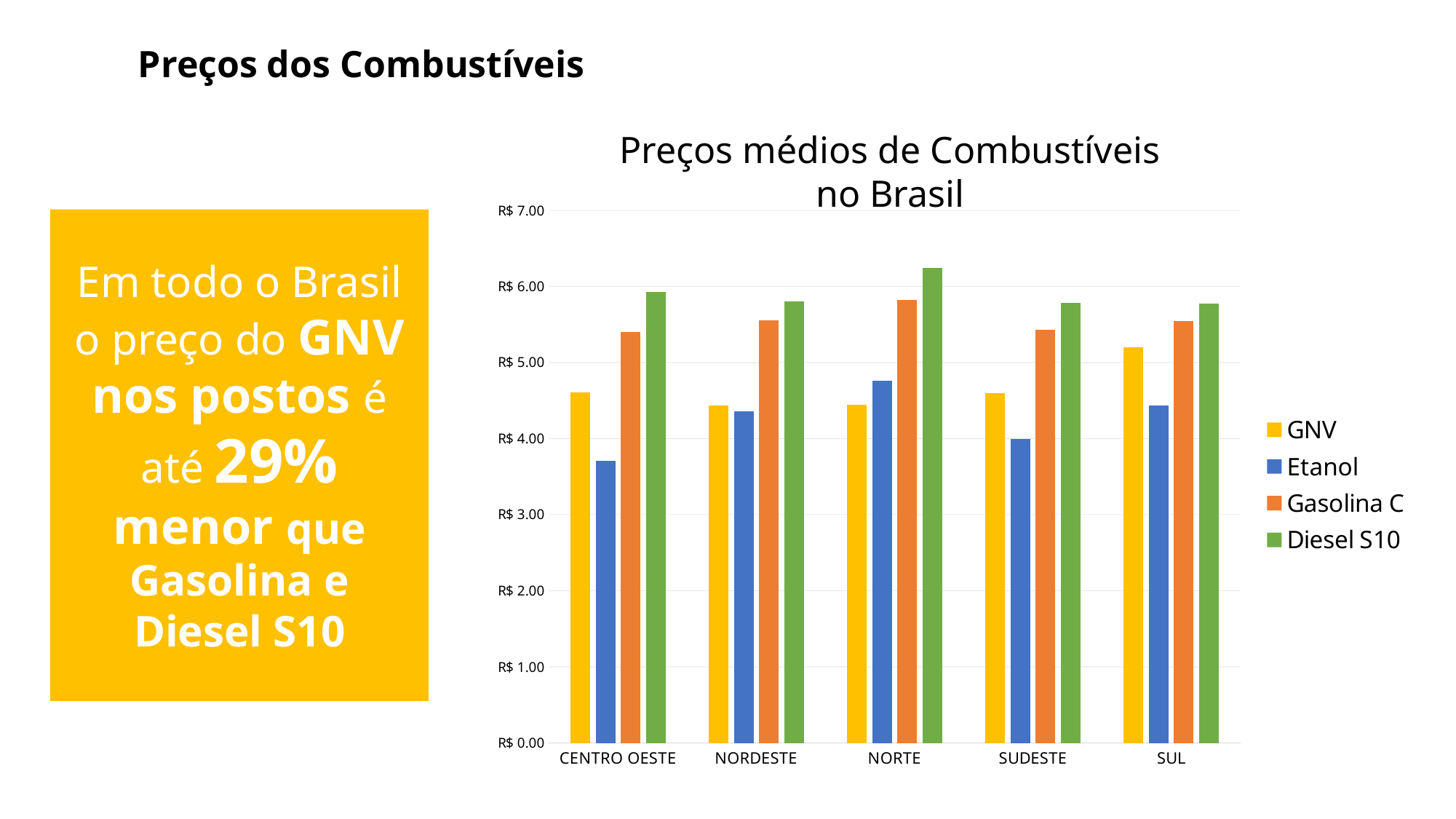
Is the GNV value for SUL greater or less than R$ 5.00? greater In which region is the Diesel S10 price highest? NORTE In SUL, which is higher: the GNV price or the Etanol price? GNV In which region is the Etanol price lowest? CENTRO OESTE Is the Etanol value for CENTRO OESTE greater or less than R$ 4.00? less How many regions are shown on the x axis of the chart? 5 In which region is the GNV price highest? SUL What is the title of the chart? Preços médios de Combustíveis no Brasil What kind of chart is shown on the slide? Bar chart In NORTE, which is higher: the GNV price or the Etanol price? Etanol How many series does the legend of the chart list? 4 Is the Diesel S10 value for NORTE greater or less than R$ 6.00? greater